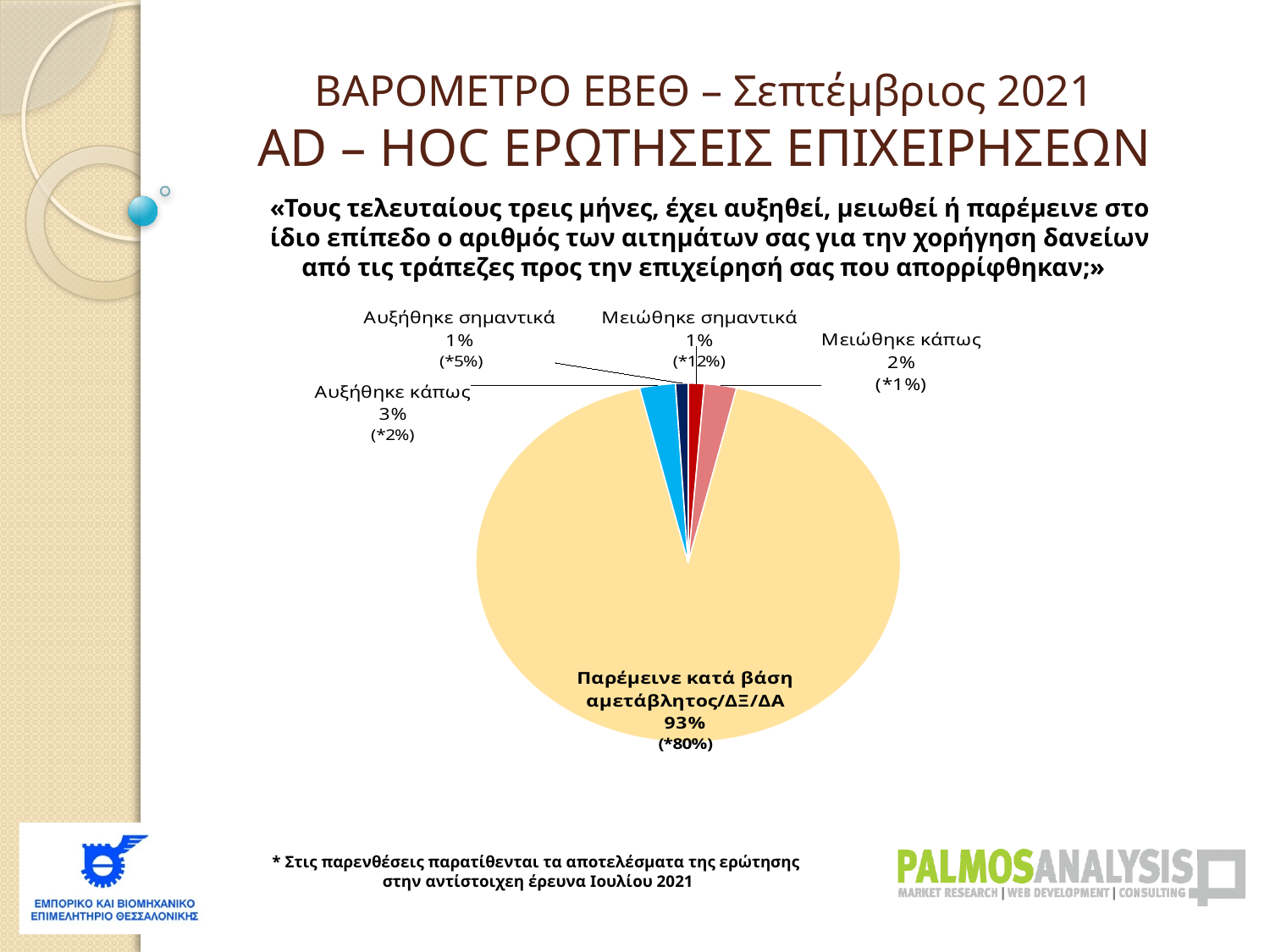
What share of the pie does "Παρέμεινε κατά βάση αμετάβλητος/ΔΞ/ΔΑ" hold? 93% Which is larger, "Αυξήθηκε κάπως" or "Μειώθηκε κάπως"? Αυξήθηκε κάπως What kind of chart is shown on the slide? pie chart What is the value shown for "Μειώθηκε κάπως"? 2% What was the July 2021 value shown in parentheses for "Παρέμεινε κατά βάση αμετάβλητος/ΔΞ/ΔΑ"? 80% What is the value shown for "Αυξήθηκε κάπως"? 3% Which category has the largest slice of the pie? Παρέμεινε κατά βάση αμετάβλητος/ΔΞ/ΔΑ What is the value shown for "Αυξήθηκε σημαντικά"? 1% What was the July 2021 value shown in parentheses for "Μειώθηκε σημαντικά"? 12% How many slices does the pie chart have? 5 What is the difference between the values for "Αυξήθηκε κάπως" and "Μειώθηκε κάπως"? 1% What is the value shown for "Μειώθηκε σημαντικά"? 1%